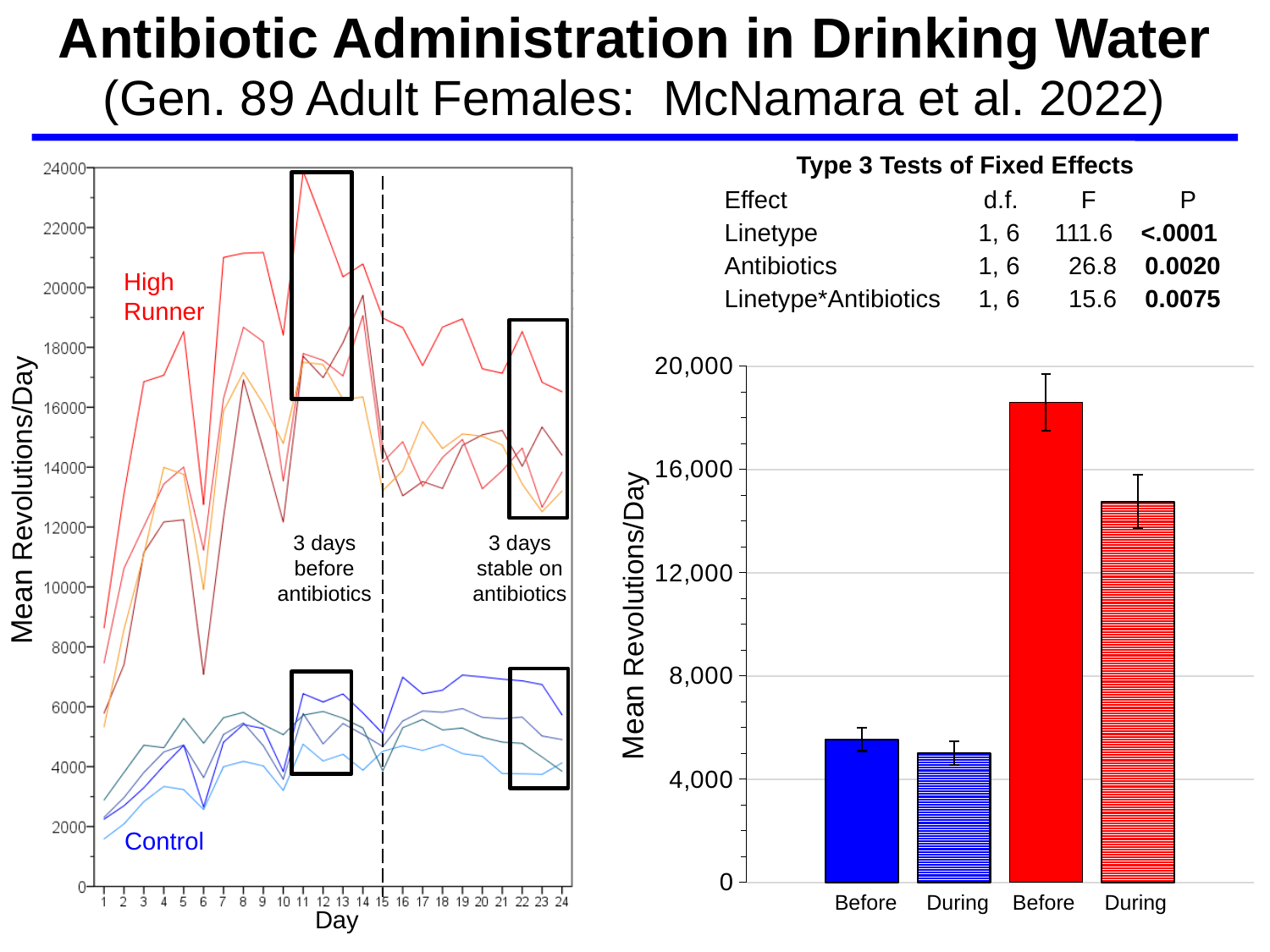
What kind of chart is the chart on the right of the slide? bar chart In the bar chart on the right, how many bars are plotted? 4 In the bar chart on the right, which bar is the highest? the red Before bar In the line chart on the left, how many days are shown on the x axis? 24 In the bar chart on the right, which bar is the lowest? the blue During bar What is the y-axis label of the line chart on the left? Mean Revolutions/Day In the bar chart on the right, which is larger, the red Before bar or the red During bar? the red Before bar What kind of chart is the chart on the left of the slide? line chart In the line chart on the left, which group has higher values, High Runner or Control? High Runner In the bar chart on the right, is the blue Before bar greater or less than 4,000? greater In the bar chart on the right, is the red During bar greater or less than 16,000? less In the bar chart on the right, is the red Before bar greater or less than 16,000? greater